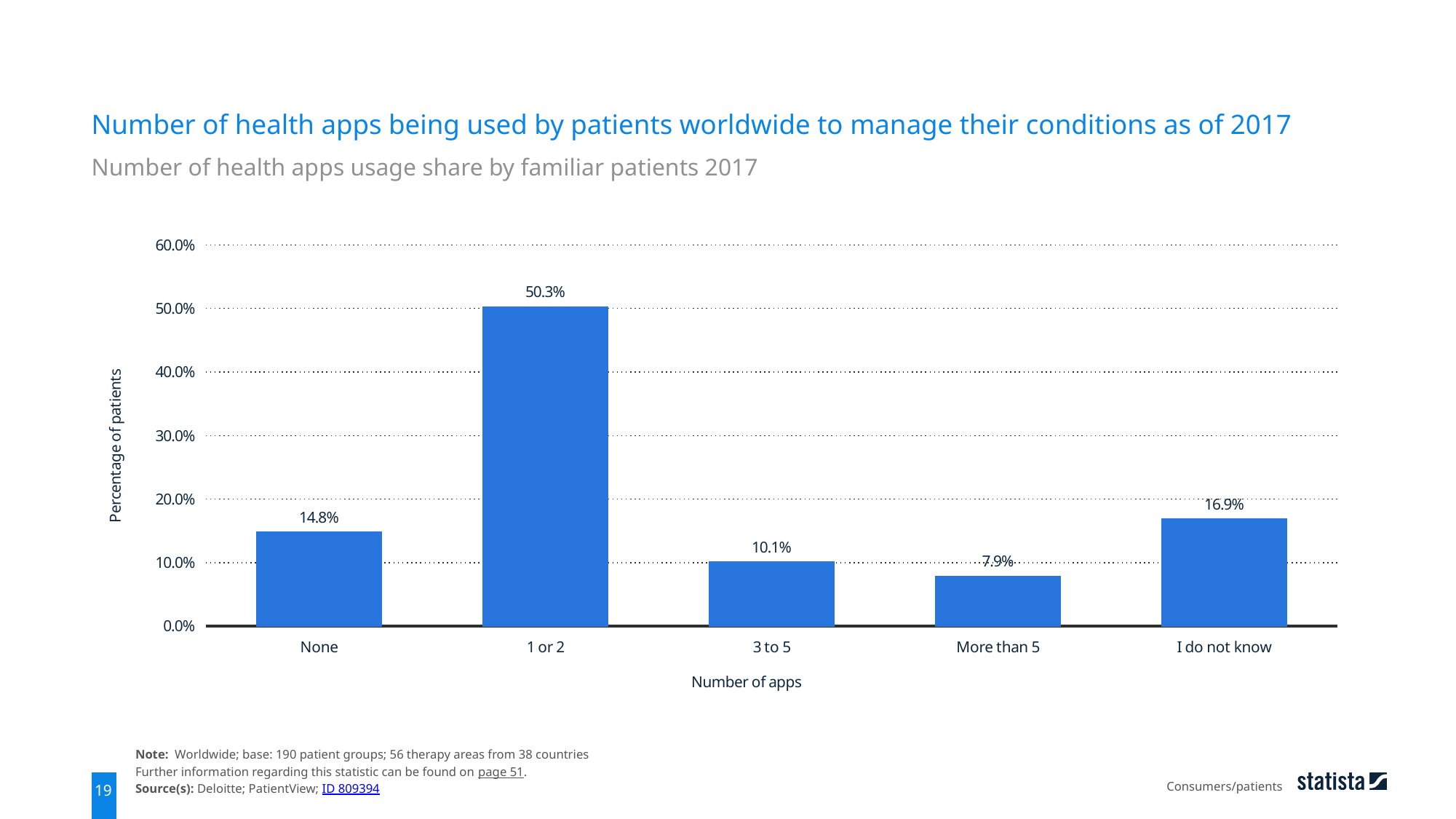
What is the value for the 'I do not know' category? 16.9% How many number-of-apps categories are shown on the x axis? 5 Is the value for '3 to 5' greater or less than 20.0%? less What type of chart is shown on the slide? Bar chart Which number-of-apps category has the highest percentage of patients? 1 or 2 What percentage of patients use 1 or 2 health apps? 50.3% What percentage of patients use no health apps (None)? 14.8% Which is larger: the value for 'I do not know' or the value for 'None'? I do not know What is the value for the 'More than 5' category? 7.9% What is the label of the y axis? Percentage of patients What is the difference in percentage points between the '1 or 2' and 'None' categories? 35.5 percentage points Which number-of-apps category has the lowest percentage of patients? More than 5